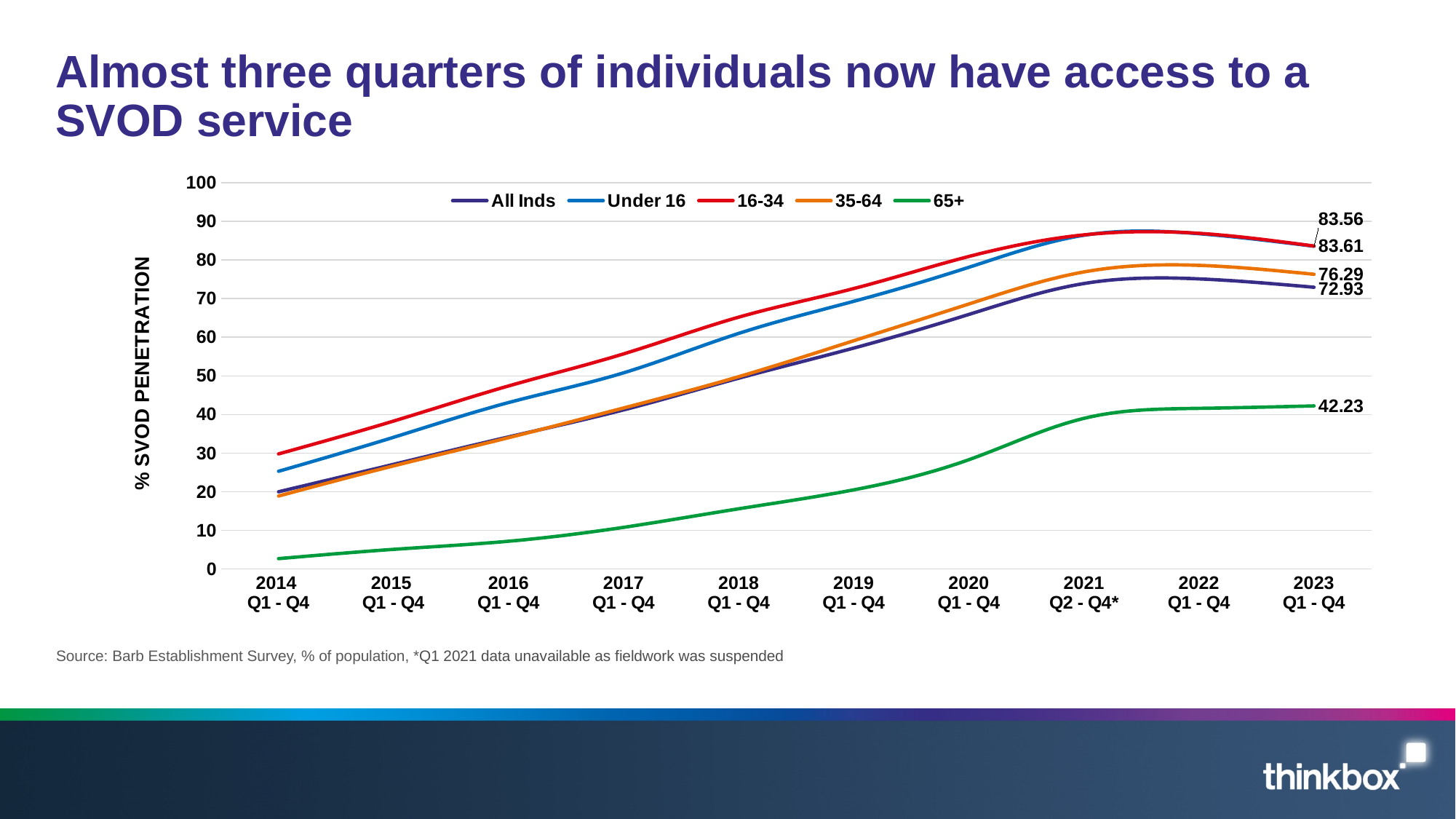
What is the difference between the 35-64 value and the All Inds value in 2023 Q1 - Q4? 3.36 In 2023 Q1 - Q4, which is larger: the 35-64 series or All Inds? 35-64 Which series has the lowest value in 2023 Q1 - Q4? 65+ Is the value for the 65+ series in 2014 Q1 - Q4 greater or less than 10? less Does the 65+ series rise or fall from 2014 to 2023? Rises What type of chart is shown on the slide? Line chart What is the value for All Inds in 2023 Q1 - Q4? 72.93 How many time periods are shown on the x axis? 10 What is the value for the 65+ series in 2023 Q1 - Q4? 42.23 What is the value for the 35-64 series in 2023 Q1 - Q4? 76.29 What is the label on the vertical axis? % SVOD PENETRATION How many series does the legend list? 5